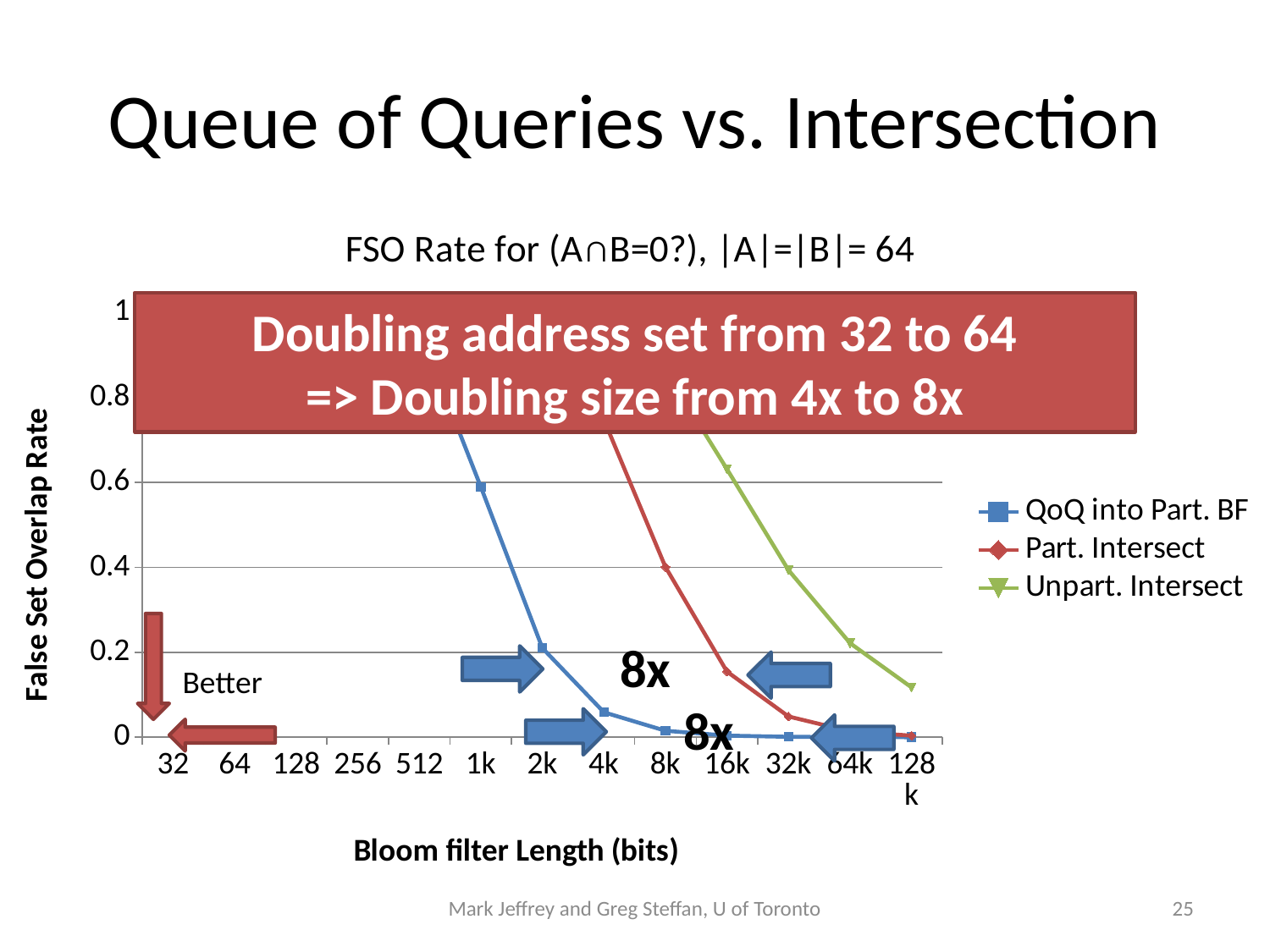
At 8k bits, which series has the higher False Set Overlap Rate: Part. Intersect or QoQ into Part. BF? Part. Intersect Which series is drawn in green in the legend? Unpart. Intersect As the Bloom filter length increases, do the False Set Overlap Rate values rise or fall? fall How many series does the legend list? 3 How many Bloom filter length values are marked along the x axis? 13 Is the False Set Overlap Rate for Part. Intersect at 16k greater or less than 0.4? less Is the False Set Overlap Rate for Unpart. Intersect at 16k greater or less than 0.4? greater At 32k bits, which series has the higher False Set Overlap Rate: Unpart. Intersect or Part. Intersect? Unpart. Intersect What is the title of the chart? FSO Rate for (A∩B=0?), |A|=|B|= 64 Is the False Set Overlap Rate for QoQ into Part. BF at 4k greater or less than 0.2? less What kind of chart is shown on the slide? line chart